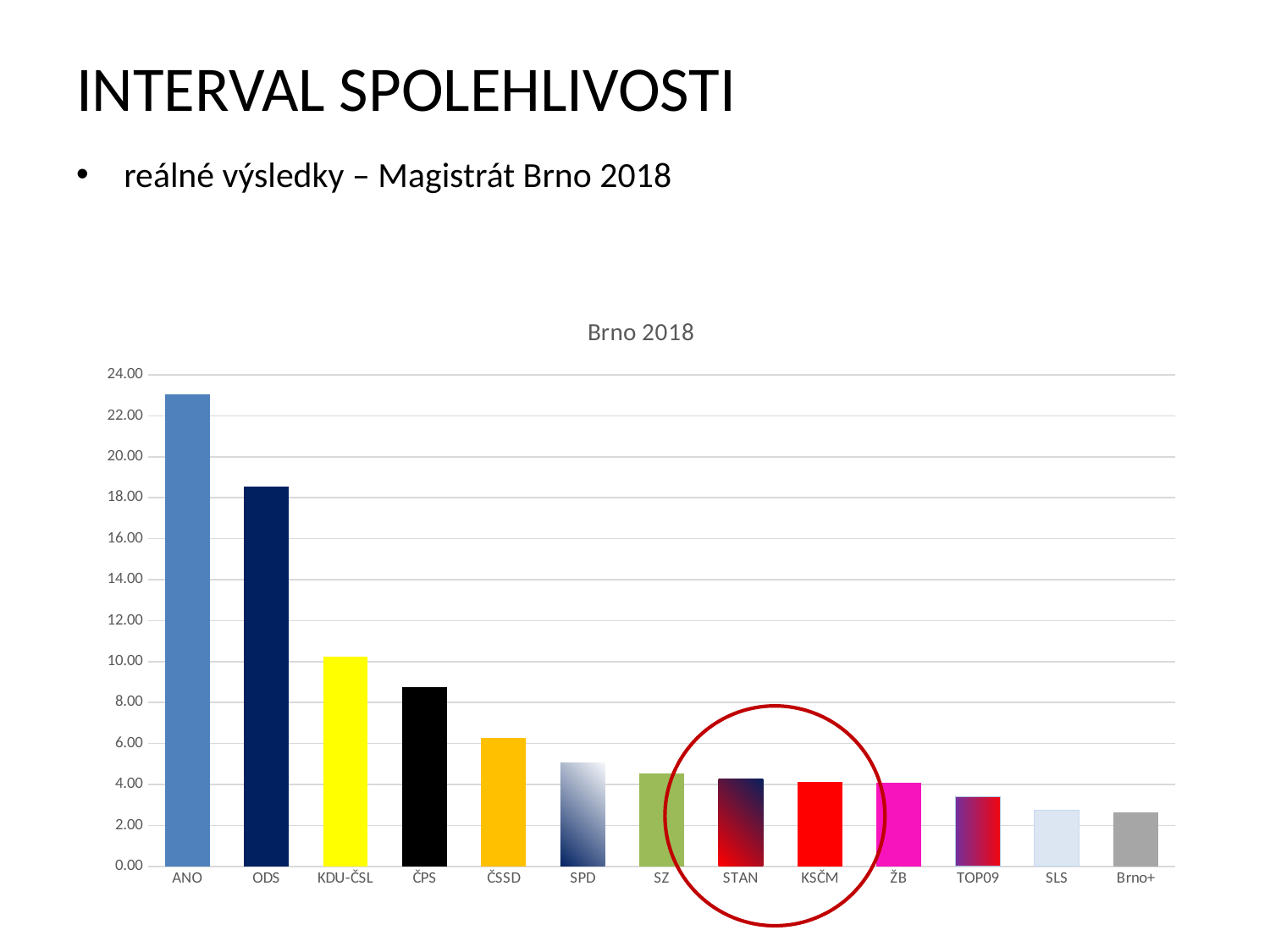
Which has the larger value, ČSSD or SPD? ČSSD Is the value for ODS greater or less than 20.00? less Is the value for KDU-ČSL greater or less than 10.00? greater Which has the larger value, ODS or KDU-ČSL? ODS What is the title of the chart? Brno 2018 Is the value for ANO greater or less than 22.00? greater How many parties (categories) are shown on the x axis of the chart? 13 Do the bar values generally rise or fall from left to right along the x axis? fall Which party has the highest bar in the chart? ANO What kind of chart is shown on the slide? bar chart